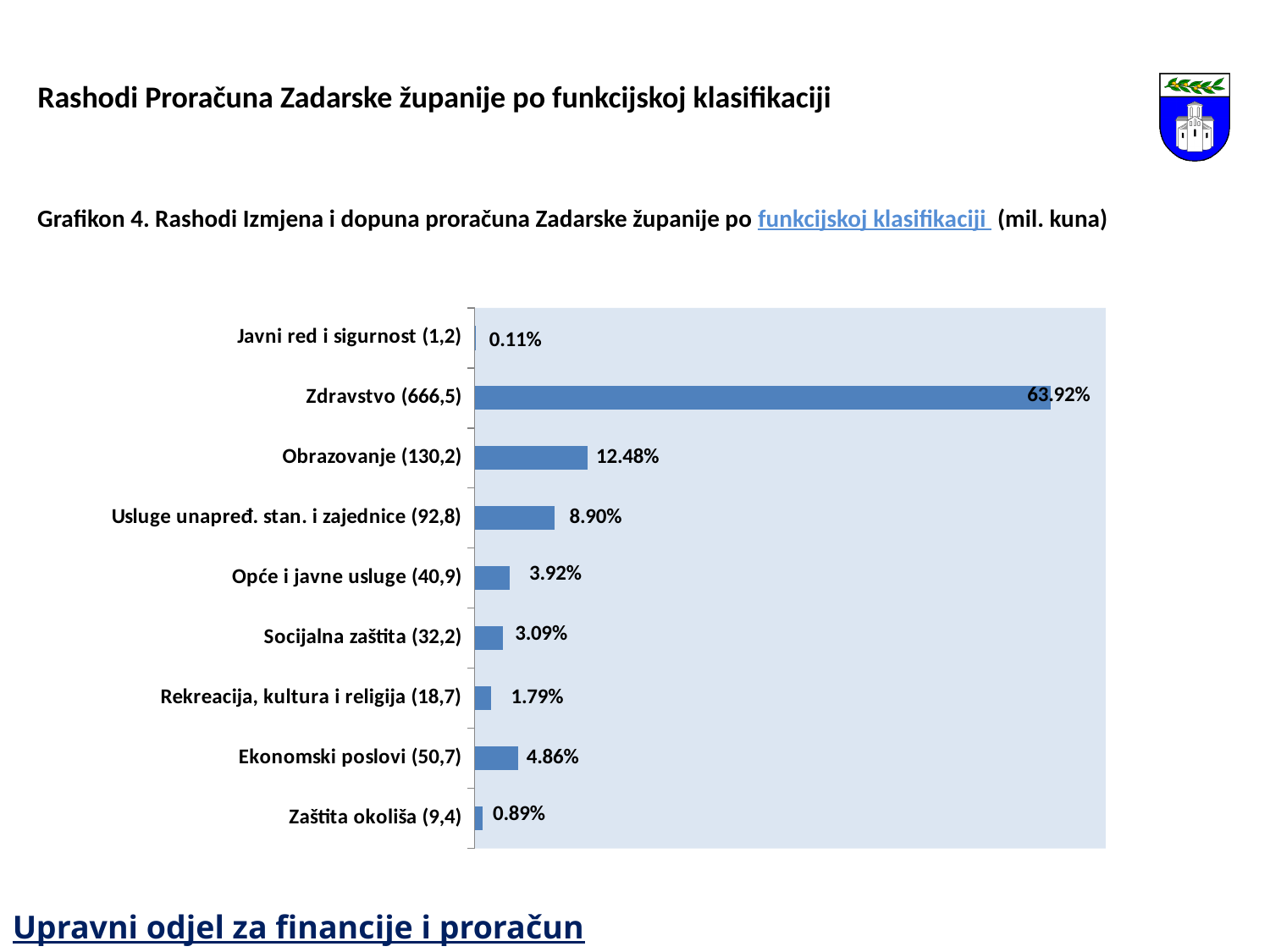
What is the value for Zdravstvo (666,5)? 63.92% How many categories are shown in the chart? 9 What is the value for Ekonomski poslovi (50,7)? 4.86% What is the value for Zaštita okoliša (9,4)? 0.89% What is the difference between the values for Obrazovanje (130,2) and Usluge unapređ. stan. i zajednice (92,8)? 3.58% Which category has the lowest value? Javni red i sigurnost (1,2) What is the value for Rekreacija, kultura i religija (18,7)? 1.79% Which category has the highest value? Zdravstvo (666,5) Which is larger, the value for Opće i javne usluge (40,9) or the value for Socijalna zaštita (32,2)? Opće i javne usluge (40,9) What is the value for Obrazovanje (130,2)? 12.48% What kind of chart is shown on the slide? Bar chart What unit is stated in the chart caption for the values in parentheses? mil. kuna